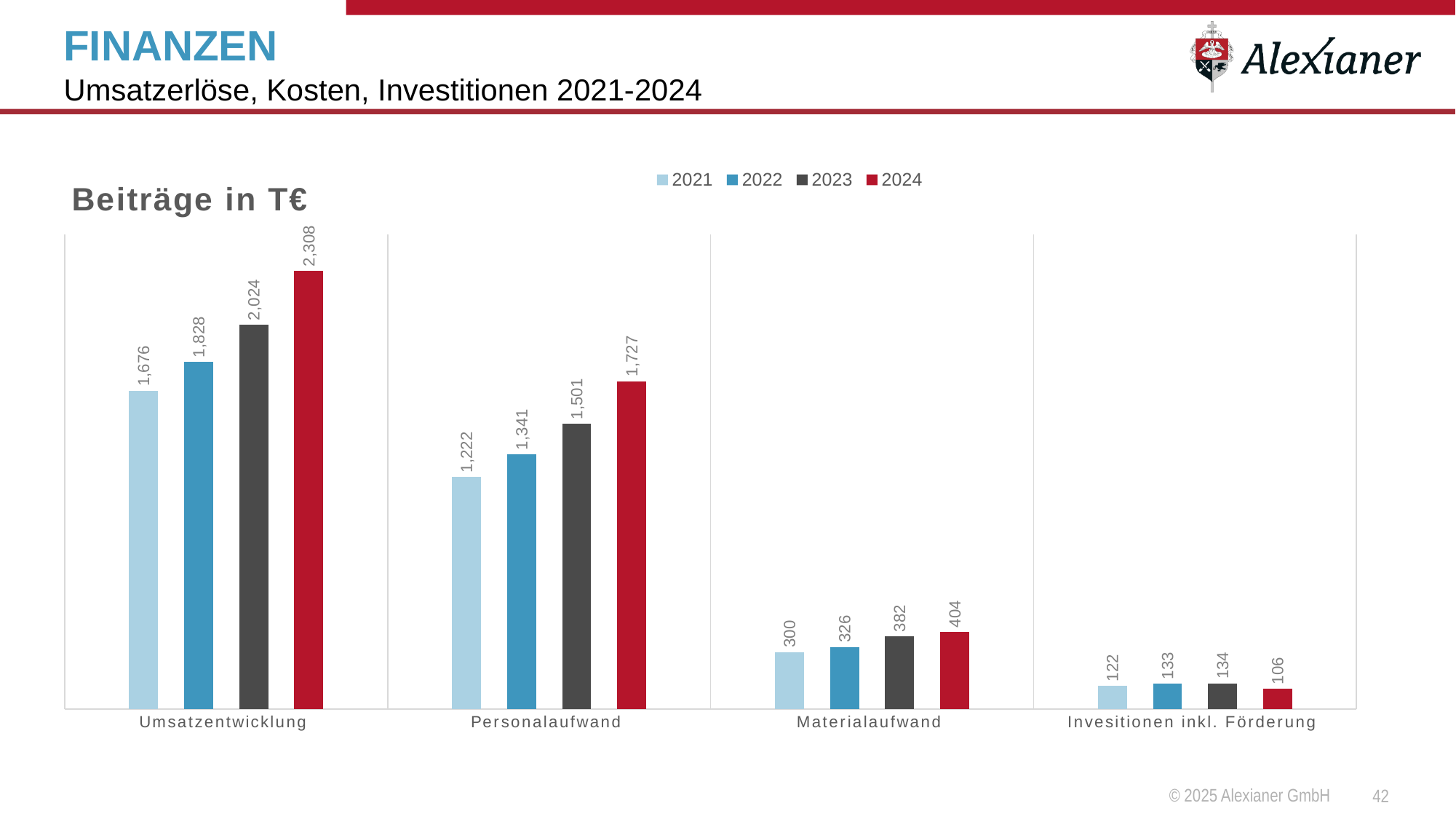
How many series does the legend list? 4 What is the value for Umsatzentwicklung in 2024? 2,308 What is the difference between the 2024 and 2023 values for Personalaufwand? 226 Which year has the highest value for Umsatzentwicklung? 2024 What is the difference between the 2024 and 2021 values for Umsatzentwicklung? 632 What is the value for Personalaufwand in 2021? 1,222 Which year has the lowest value for Invesitionen inkl. Förderung? 2024 What is the value for Invesitionen inkl. Förderung in 2024? 106 What kind of chart is shown on the slide? Bar chart How many categories are shown on the x axis? 4 What is the value for Materialaufwand in 2023? 382 Which is larger: Materialaufwand in 2022 or Invesitionen inkl. Förderung in 2022? Materialaufwand in 2022